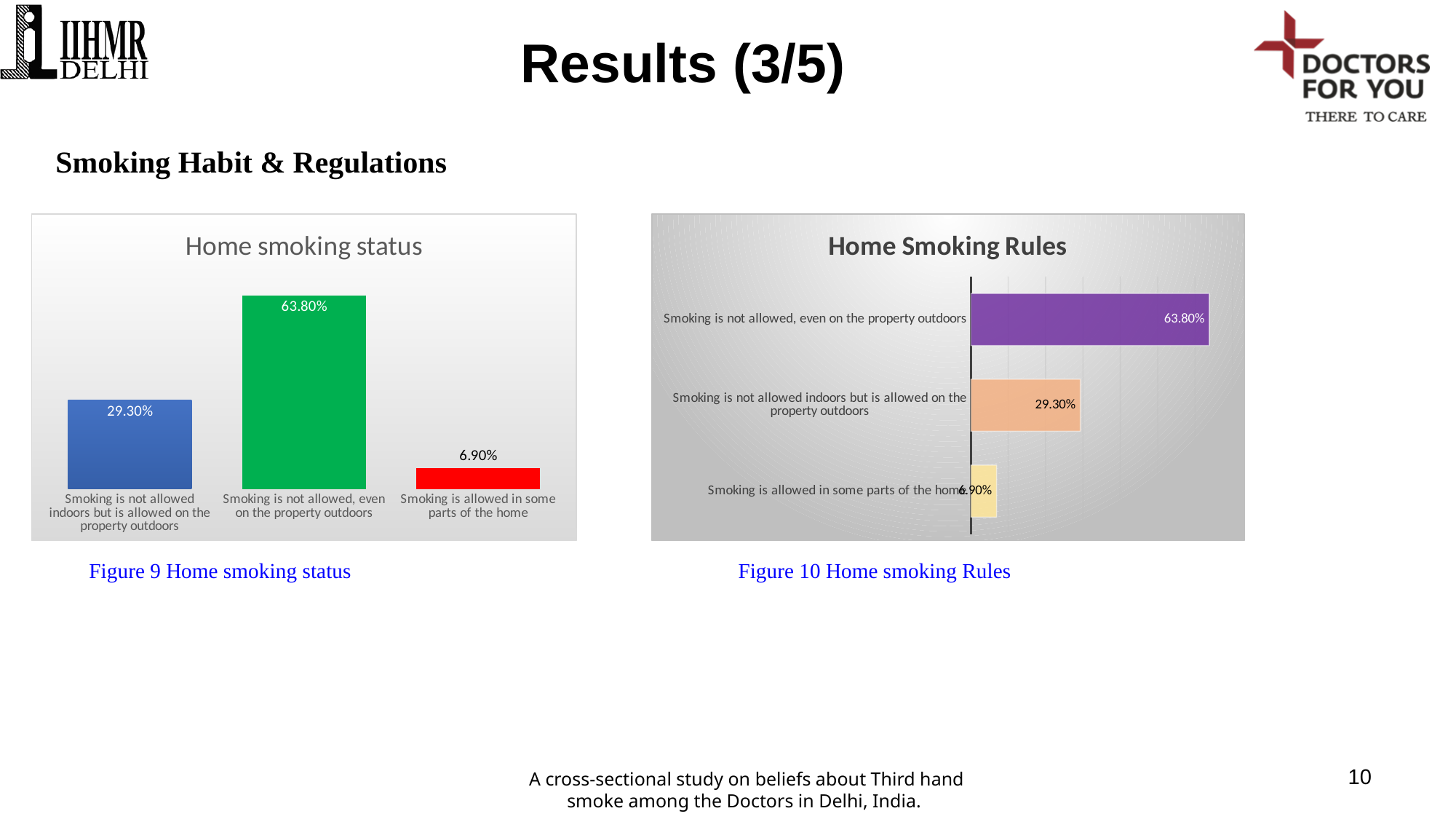
In the 'Home smoking status' chart, what is the difference between the values for 'Smoking is not allowed, even on the property outdoors' and 'Smoking is not allowed indoors but is allowed on the property outdoors'? 34.50% What type of chart is the 'Home smoking status' chart? Bar chart In the 'Home Smoking Rules' chart, what is the difference between the values for 'Smoking is not allowed indoors but is allowed on the property outdoors' and 'Smoking is allowed in some parts of the home'? 22.40% In the 'Home smoking status' chart, what is the value for 'Smoking is allowed in some parts of the home'? 6.90% In the 'Home smoking status' chart, which category has the highest value? Smoking is not allowed, even on the property outdoors In the 'Home smoking status' chart, what is the value for 'Smoking is not allowed, even on the property outdoors'? 63.80% In the 'Home smoking status' chart, what colour is the bar for 'Smoking is allowed in some parts of the home'? Red How many categories are shown in the 'Home Smoking Rules' chart? 3 In the 'Home smoking status' chart, which is larger: the value for 'Smoking is not allowed indoors but is allowed on the property outdoors' or 'Smoking is allowed in some parts of the home'? Smoking is not allowed indoors but is allowed on the property outdoors In the 'Home Smoking Rules' chart, which category has the lowest value? Smoking is allowed in some parts of the home What is the title of the chart on the right side of the slide? Home Smoking Rules In the 'Home Smoking Rules' chart, what is the value for 'Smoking is not allowed indoors but is allowed on the property outdoors'? 29.30%